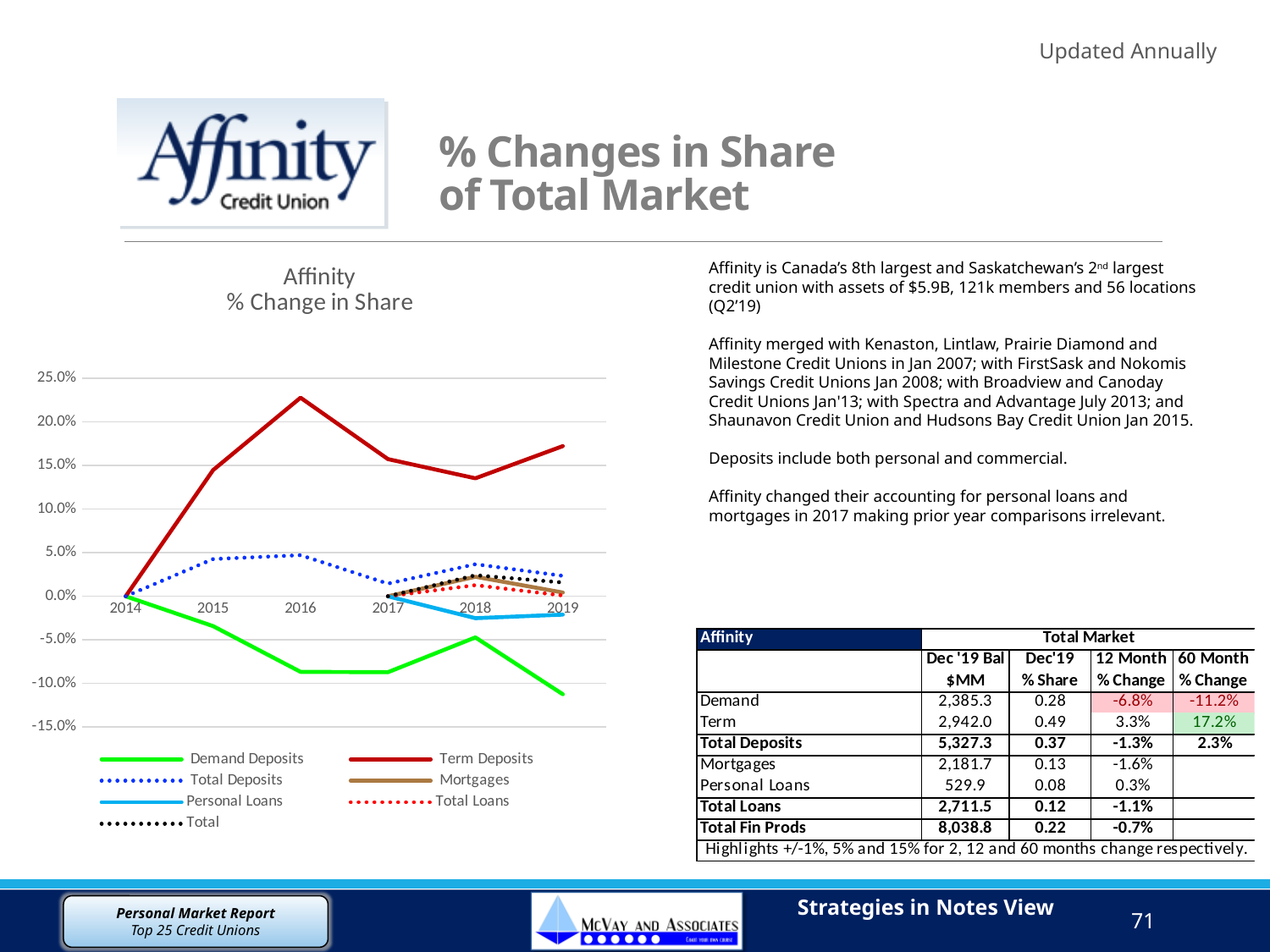
How many series does the chart legend list? 7 In 2019, which is larger: the value for Term Deposits or the value for Demand Deposits? Term Deposits How many years are shown along the x axis of the chart? 6 Is the value for Demand Deposits in 2017 greater or less than -5.0%? less Which series has the lowest value in 2019? Demand Deposits What kind of chart is shown on the slide? line chart Does the Demand Deposits line rise or fall from 2014 to 2016? fall What is the title of the chart? Affinity % Change in Share Which series reaches the highest value on the chart? Term Deposits Is the value for Term Deposits in 2019 greater or less than 15.0%? greater Is the value for Term Deposits in 2016 greater or less than 20.0%? greater